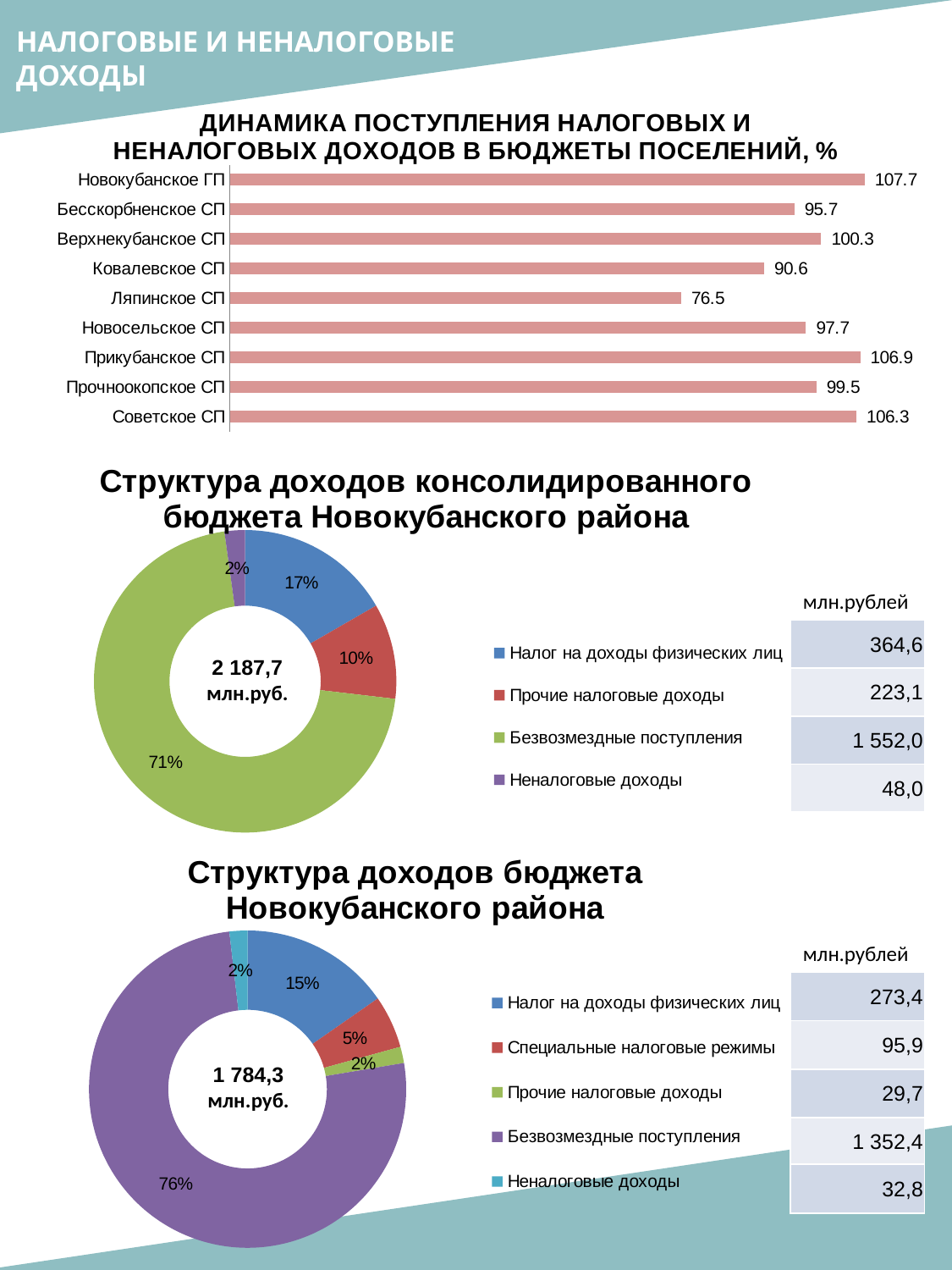
In the bar chart 'Динамика поступления налоговых и неналоговых доходов в бюджеты поселений, %', which is larger: the value for Бесскорбненское СП or Новосельское СП? Новосельское СП How many settlements are shown in the bar chart 'Динамика поступления налоговых и неналоговых доходов в бюджеты поселений, %'? 9 In the bar chart 'Динамика поступления налоговых и неналоговых доходов в бюджеты поселений, %', what is the value for Ляпинское СП? 76.5 In the bar chart 'Динамика поступления налоговых и неналоговых доходов в бюджеты поселений, %', which settlement has the highest value? Новокубанское ГП In the chart 'Структура доходов консолидированного бюджета Новокубанского района', what is the value in млн.рублей for Налог на доходы физических лиц? 364,6 What type of chart is 'Динамика поступления налоговых и неналоговых доходов в бюджеты поселений, %'? Bar chart In the bar chart 'Динамика поступления налоговых и неналоговых доходов в бюджеты поселений, %', what is the value for Прикубанское СП? 106.9 In the chart 'Структура доходов бюджета Новокубанского района', what total amount is shown in the centre of the doughnut? 1 784,3 млн.руб. How many series does the legend list in the chart 'Структура доходов бюджета Новокубанского района'? 5 In the bar chart 'Динамика поступления налоговых и неналоговых доходов в бюджеты поселений, %', which settlement has the lowest value? Ляпинское СП In the chart 'Структура доходов консолидированного бюджета Новокубанского района', what share do Безвозмездные поступления make up? 71% In the bar chart 'Динамика поступления налоговых и неналоговых доходов в бюджеты поселений, %', what is the difference between the values for Советское СП and Ковалевское СП? 15.7